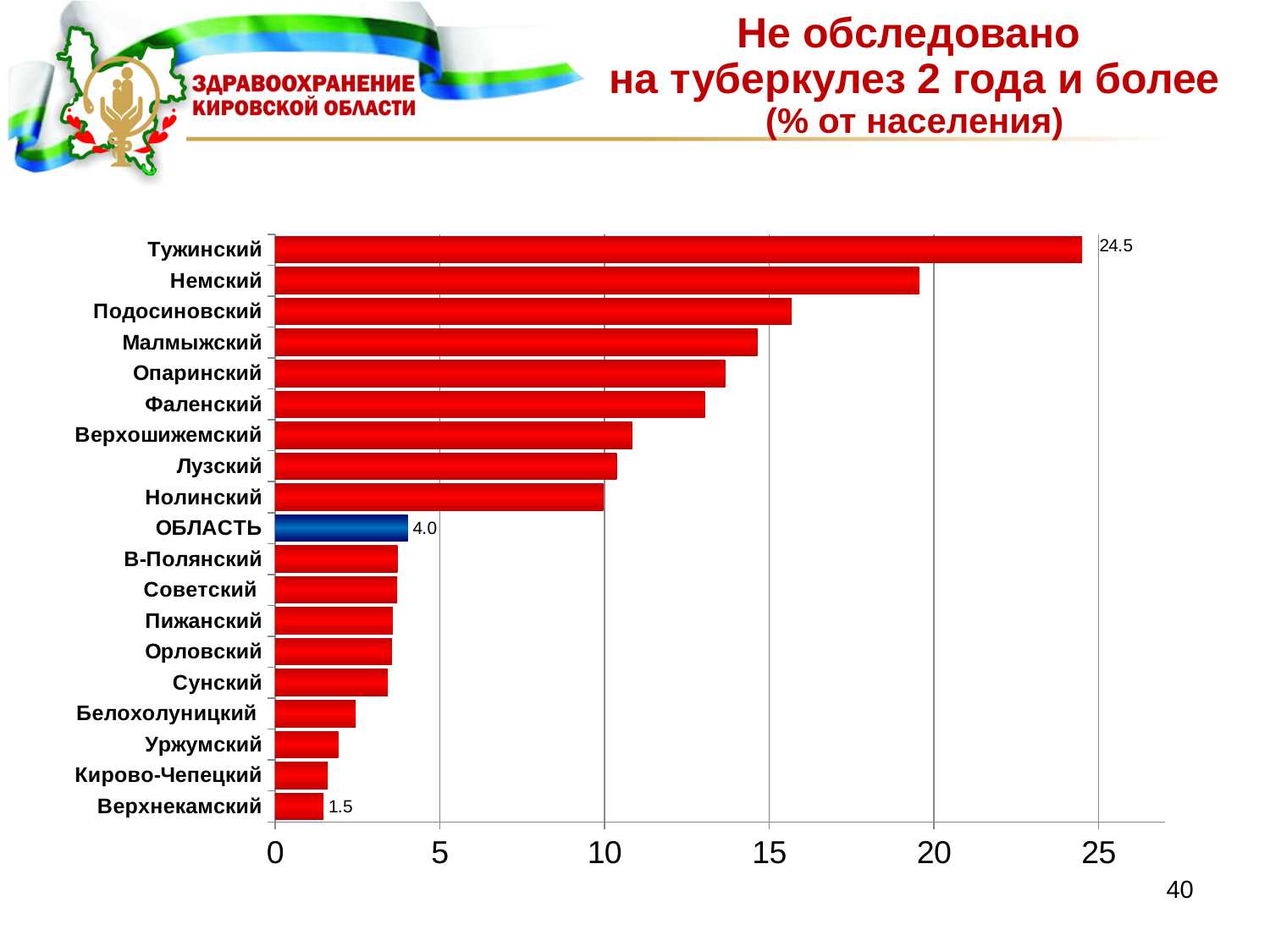
What is the value for Тужинский? 24.5 Which category has the highest value? Тужинский What is the difference between the values for Тужинский and ОБЛАСТЬ? 20.5 Which category has the lowest value? Верхнекамский Which category's bar is coloured blue instead of red? ОБЛАСТЬ How many categories are shown in the chart? 19 What kind of chart is shown on the slide? bar chart What is the value for ОБЛАСТЬ? 4.0 What is the difference between the values for ОБЛАСТЬ and Верхнекамский? 2.5 What is the value for Верхнекамский? 1.5 Which has a larger value, Немский or Подосиновский? Немский Is the value for Фаленский greater or less than 15? less